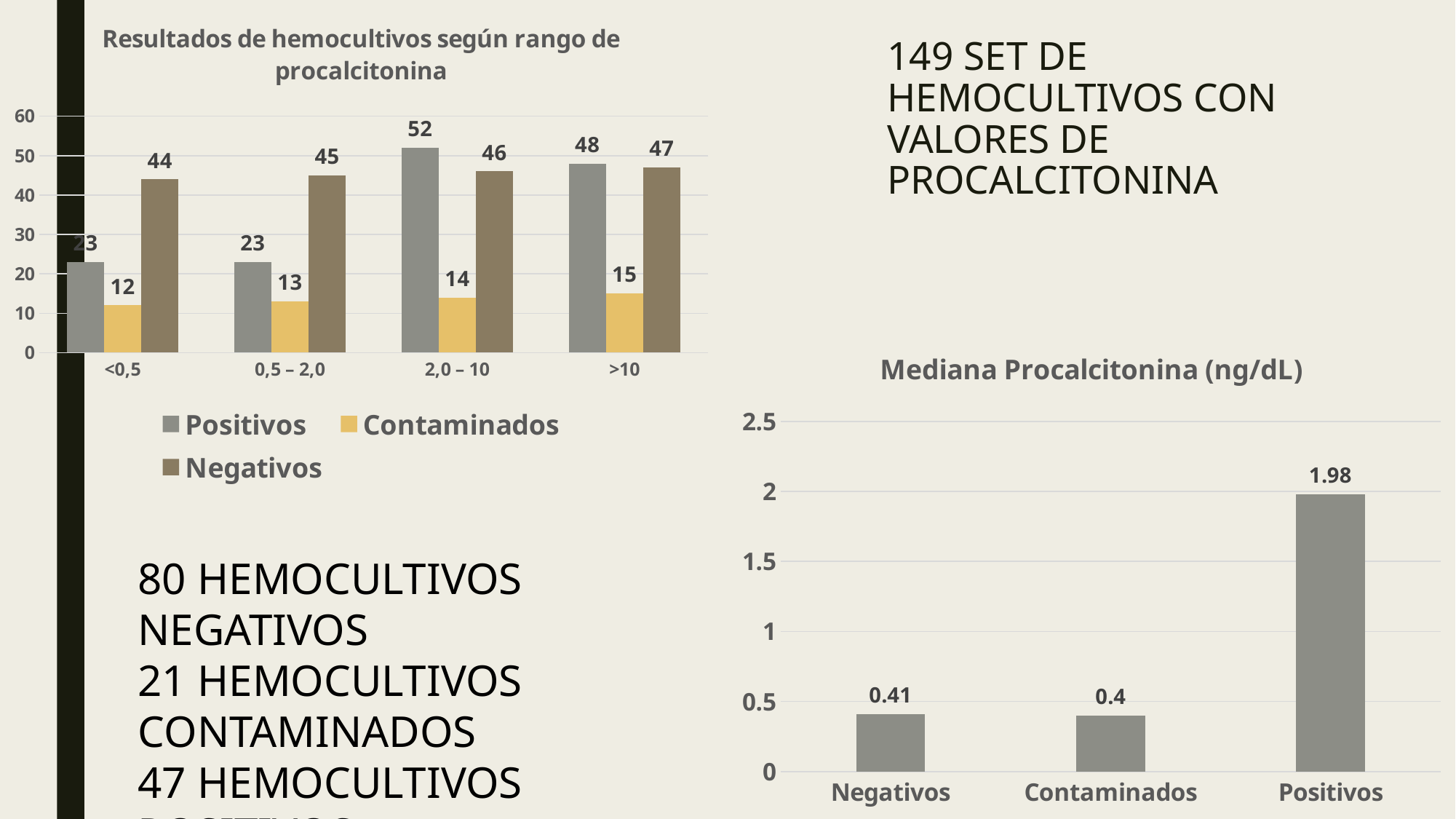
In the chart 'Mediana Procalcitonina (ng/dL)', what is the difference between Positivos and Negativos? 1.57 In the chart 'Resultados de hemocultivos según rango de procalcitonina', which procalcitonin range has the highest Positivos value? 2,0 – 10 In the chart 'Resultados de hemocultivos según rango de procalcitonina', what is the value for Positivos in the '2,0 – 10' range? 52 In the chart 'Resultados de hemocultivos según rango de procalcitonina', what is the value for Contaminados in the '<0,5' range? 12 What kind of chart is 'Mediana Procalcitonina (ng/dL)'? bar chart In the chart 'Resultados de hemocultivos según rango de procalcitonina', do the Contaminados values rise or fall from '<0,5' to '>10'? rise In the chart 'Resultados de hemocultivos según rango de procalcitonina', what is the value for Negativos in the '>10' range? 47 In the chart 'Resultados de hemocultivos según rango de procalcitonina', how many procalcitonin ranges are shown on the x axis? 4 In the chart 'Resultados de hemocultivos según rango de procalcitonina', what is the difference between Positivos and Contaminados in the '>10' range? 33 In the chart 'Mediana Procalcitonina (ng/dL)', which category has the lowest value? Contaminados In the chart 'Resultados de hemocultivos según rango de procalcitonina', how many series does the legend list? 3 In the chart 'Mediana Procalcitonina (ng/dL)', what is the value for Positivos? 1.98